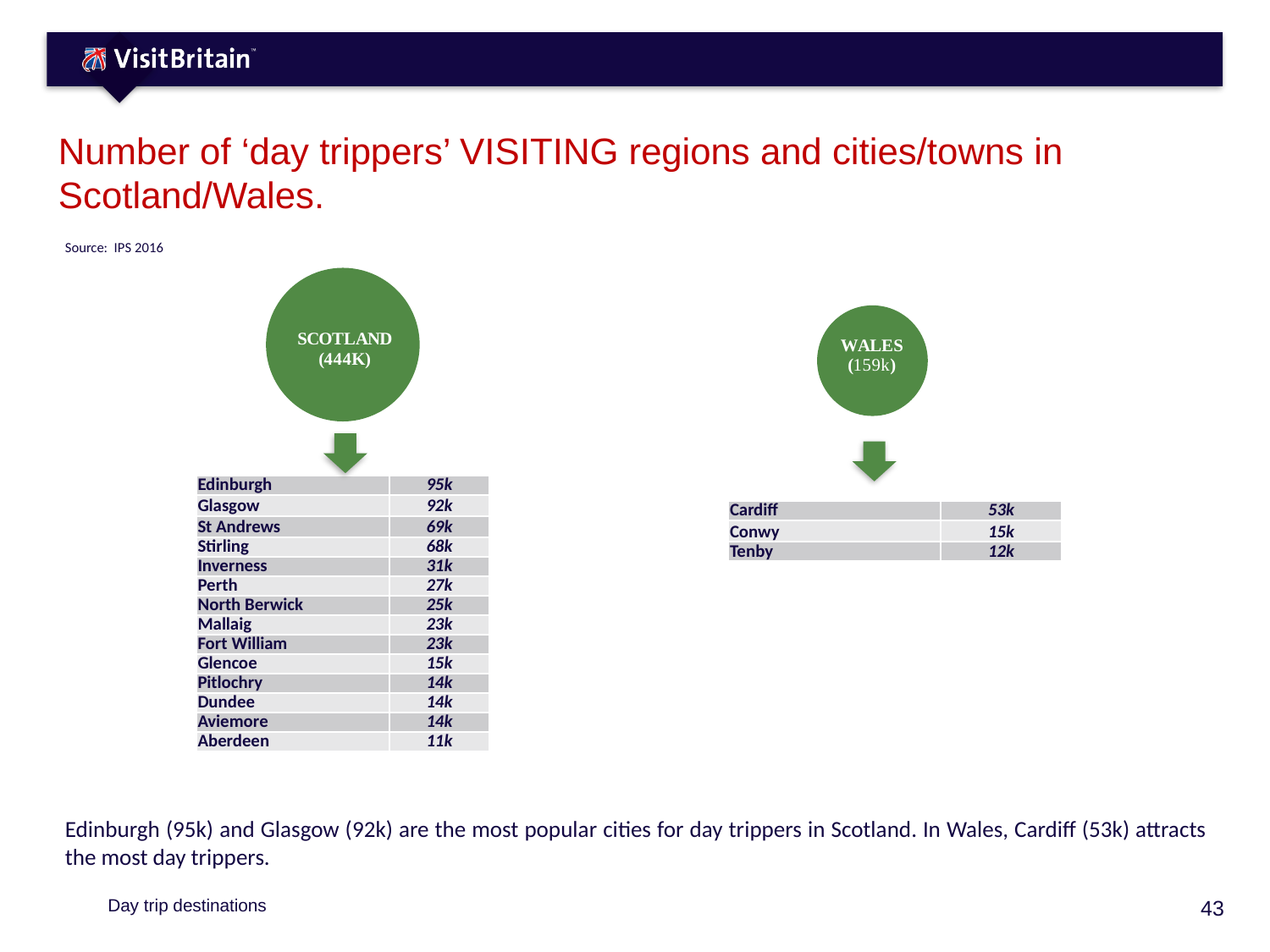
In the Wales table, which destination has the lowest value? Tenby In the Wales table, what is the difference between Cardiff and Tenby? 41k How many destinations are listed in the Wales table? 3 How many destinations are listed in the Scotland table? 14 In the Scotland table, which is larger, St Andrews or Inverness? St Andrews In the Scotland table, which destination has the lowest number of day trippers? Aberdeen In the Scotland table, which destination has the highest number of day trippers? Edinburgh In the Scotland table, what is the value for Stirling? 68k In the Scotland table, what is the difference between Edinburgh and Glasgow? 3k In the Scotland table, how many day trippers visited Edinburgh? 95k In the Wales table, what is the value for Conwy? 15k What total number of day trippers is shown in the Scotland circle? 444K